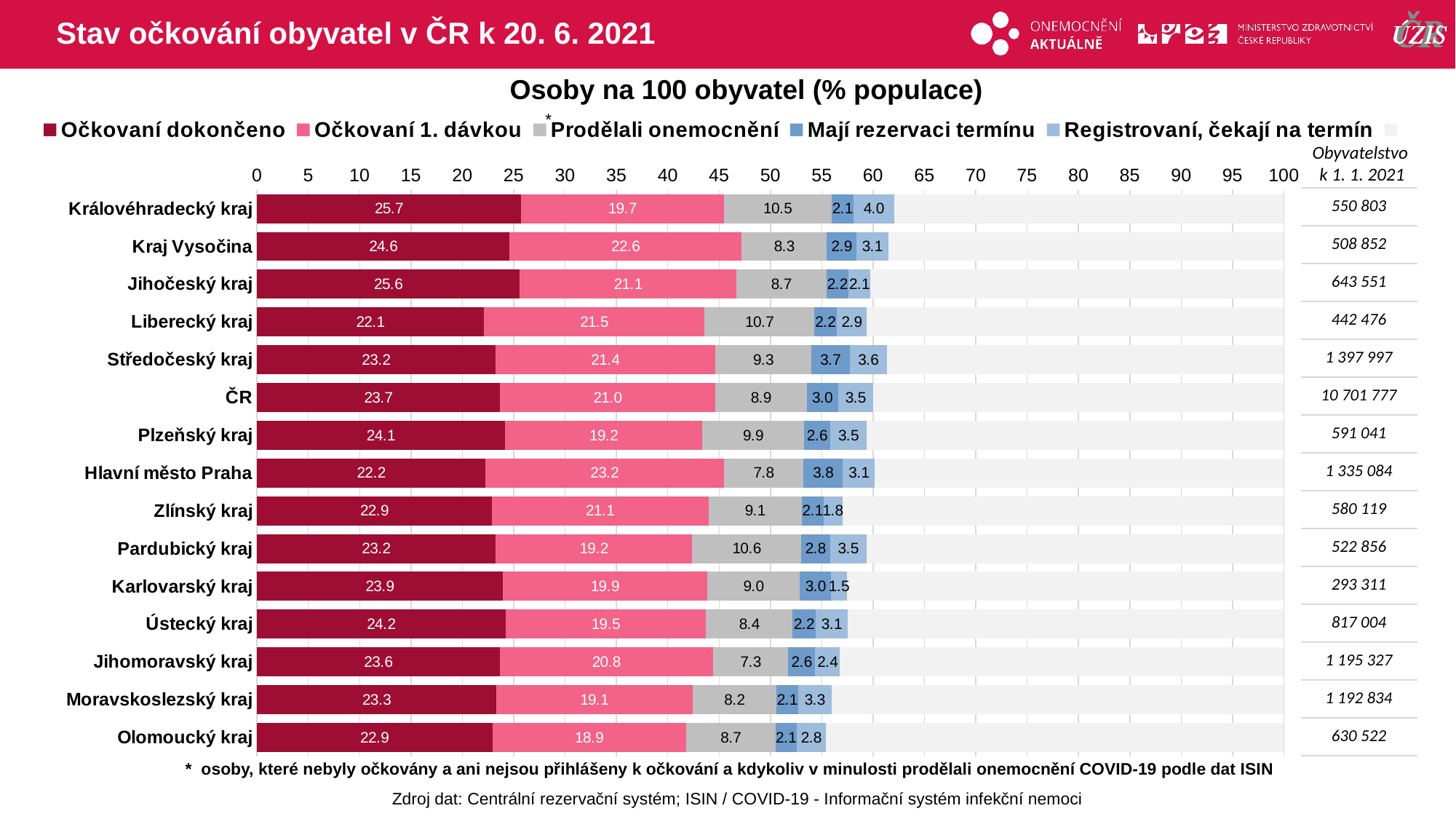
What is the value of Očkovaní dokončeno for Královéhradecký kraj? 25.7 What is the difference between the Očkovaní dokončeno values for Královéhradecký kraj and Liberecký kraj? 3.6 What is the value of Očkovaní 1. dávkou for Hlavní město Praha? 23.2 Which region has the lowest value for Prodělali onemocnění? Jihomoravský kraj How many regions (rows) are shown in the chart? 15 What is the value of Mají rezervaci termínu for Středočeský kraj? 3.7 What is the title of the chart? Osoby na 100 obyvatel (% populace) Which has a larger Očkovaní 1. dávkou value, Kraj Vysočina or Jihočeský kraj? Kraj Vysočina What is the value of Prodělali onemocnění for Liberecký kraj? 10.7 Which region has the highest value for Registrovaní, čekají na termín? Královéhradecký kraj Which region has the highest value for Očkovaní 1. dávkou? Hlavní město Praha What kind of chart is shown on the slide? Stacked bar chart